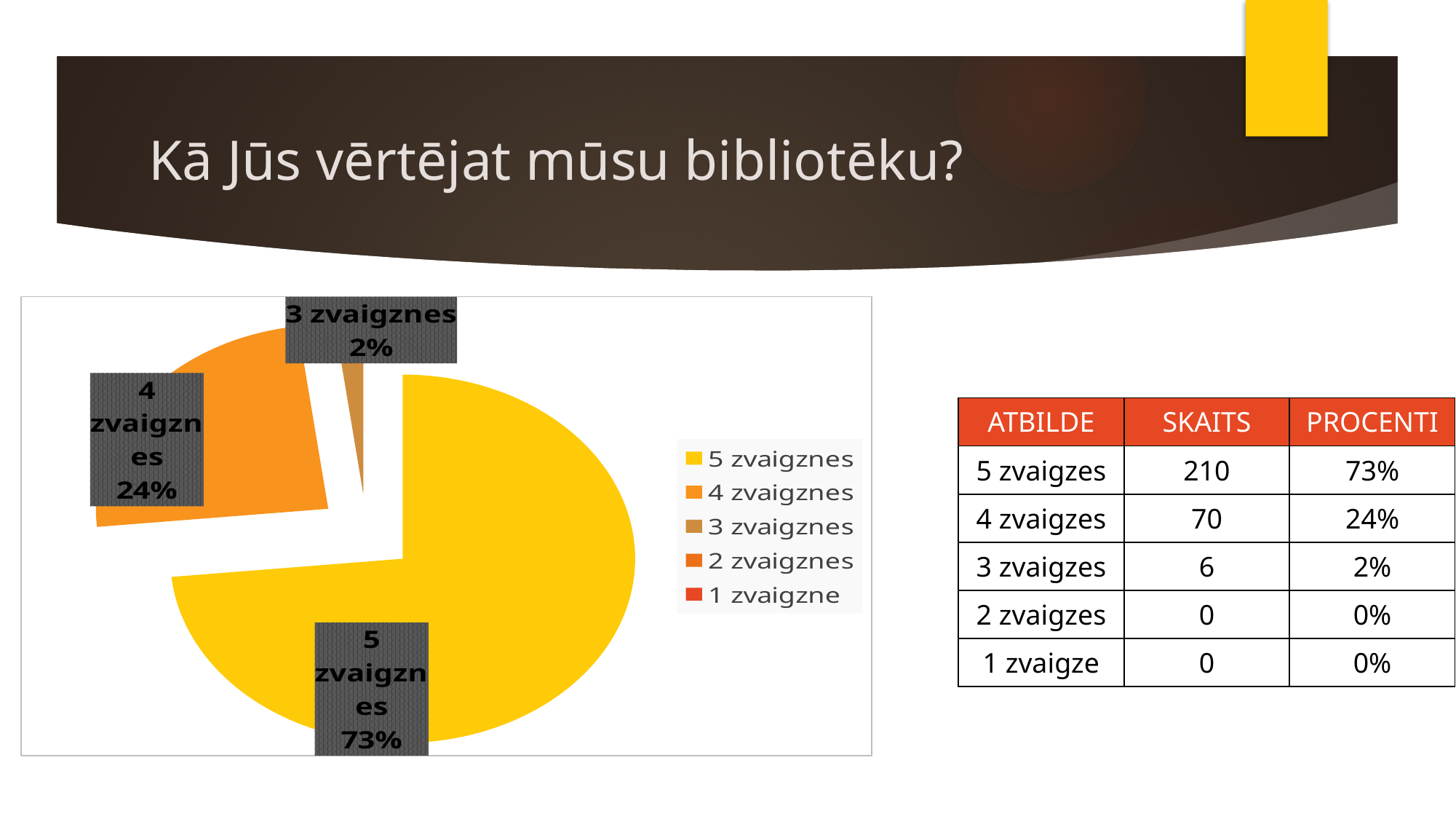
How many entries does the chart legend list? 5 Which of the labelled slices is the smallest? 3 zvaigznes What share of the pie does the "3 zvaigznes" slice represent? 2% What type of chart is shown on the slide? pie chart How many slices in the pie have a data label? 3 What is the title of the slide containing the chart? Kā Jūs vērtējat mūsu bibliotēku? What share of the pie does the "5 zvaigznes" slice represent? 73% What colour is the "5 zvaigznes" slice? yellow What is the difference in percentage points between the "5 zvaigznes" and "4 zvaigznes" slices? 49 Which slice is larger, "4 zvaigznes" or "3 zvaigznes"? 4 zvaigznes What share of the pie does the "4 zvaigznes" slice represent? 24% Which category has the largest slice of the pie? 5 zvaigznes